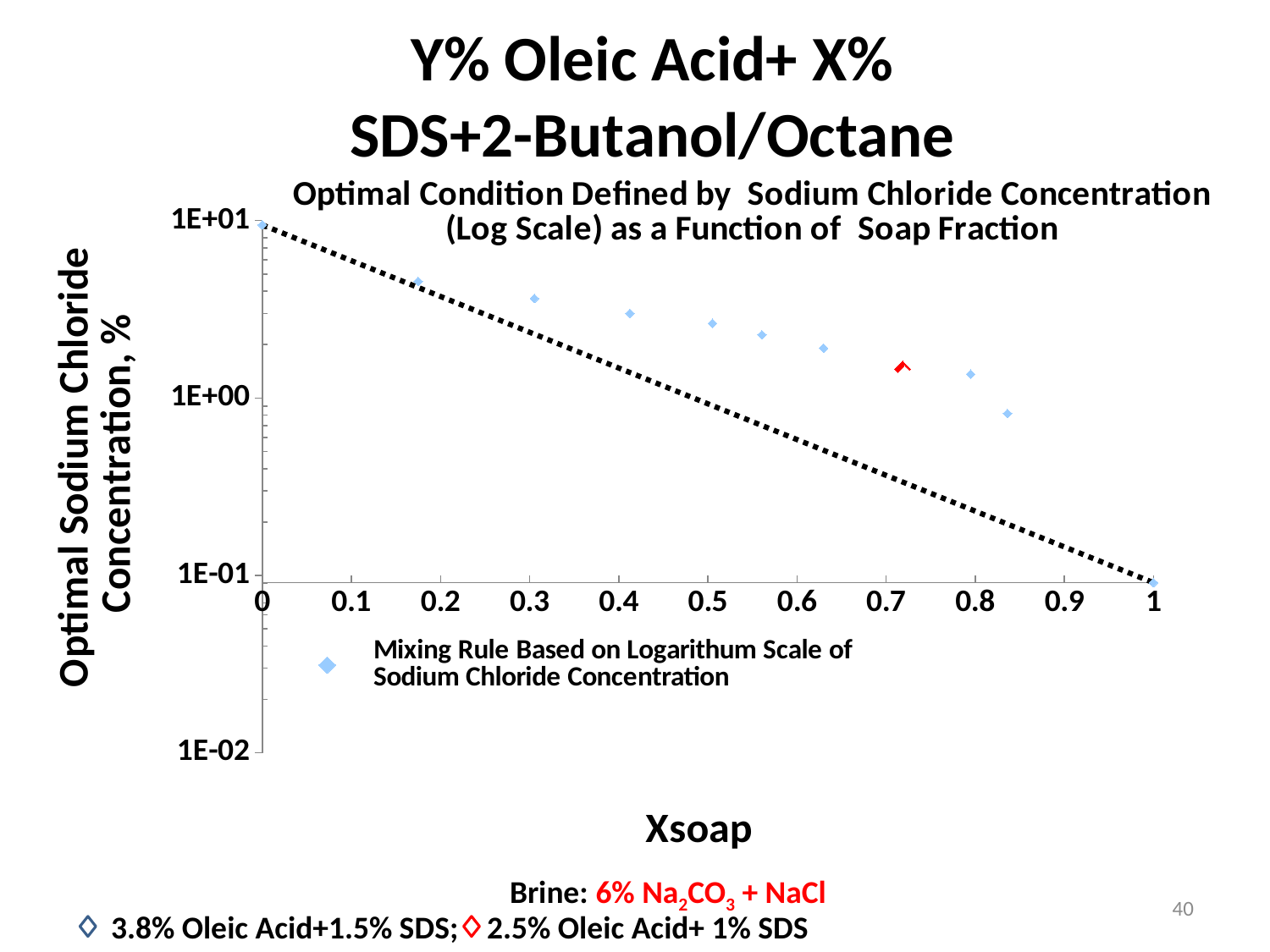
As Xsoap increases from 0 to 1, do the plotted optimal sodium chloride concentrations rise or fall? fall What kind of chart is shown on the slide? scatter chart What is the legend entry shown below the chart? Mixing Rule Based on Logarithum Scale of Sodium Chloride Concentration How many series does the legend list? 1 Is the red data point's value greater or less than 1E+00? greater Is the plotted value at Xsoap 0.3 greater or less than 1E+00? greater What is the label of the x axis? Xsoap How many red data points are plotted on the chart? 1 Which plotted point has the highest optimal sodium chloride concentration, the one at Xsoap 0 or the one at Xsoap 1? Xsoap 0 Is the plotted value at Xsoap 0.5 greater or less than 1E+00? greater At which Xsoap value does the lowest plotted point occur? 1